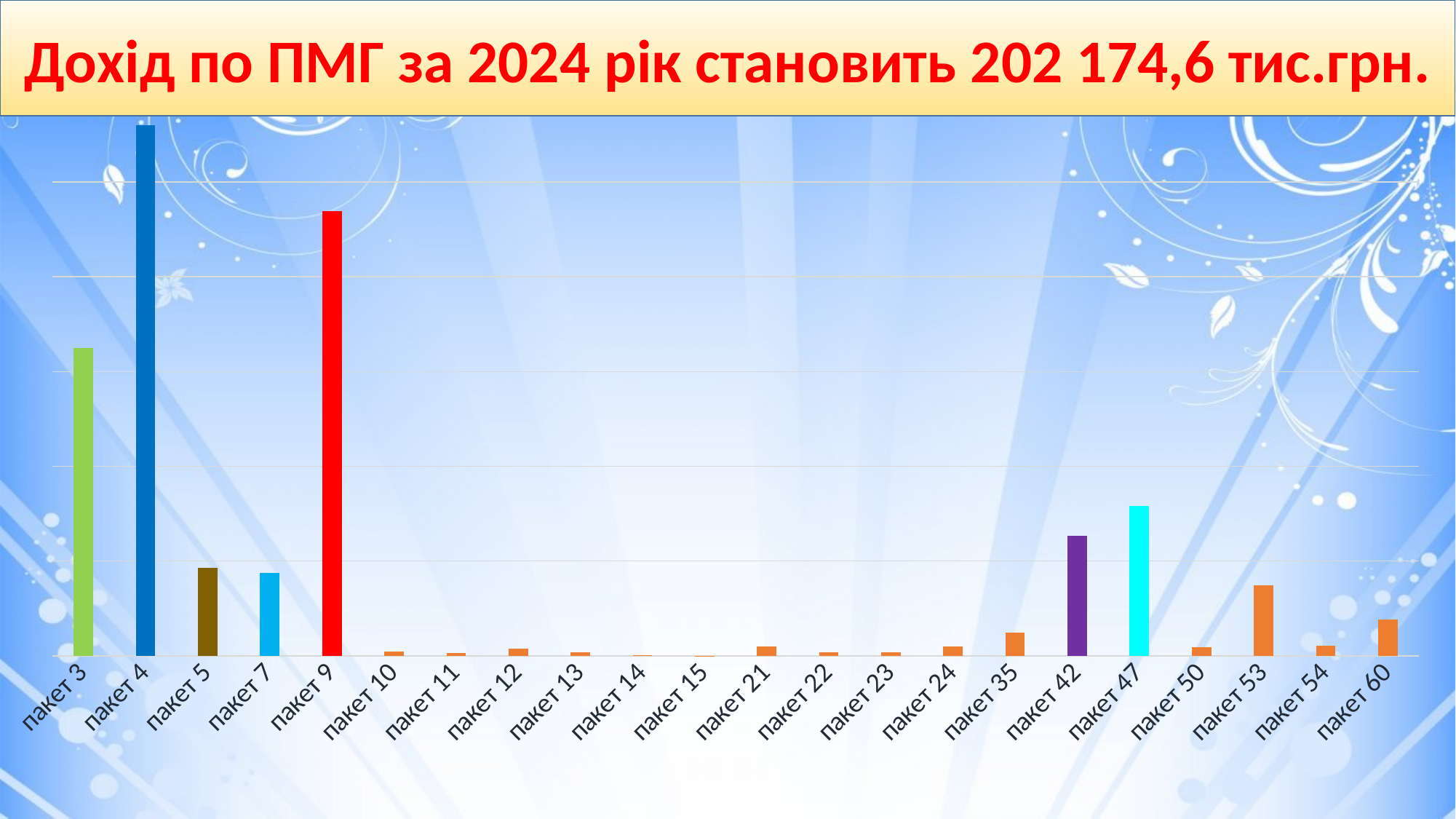
Which is larger, the value for пакет 42 or the value for пакет 47? пакет 47 How many categories (packages) are shown on the x axis of the chart? 22 Which is larger, the value for пакет 53 or the value for пакет 60? пакет 53 Which is larger, the value for пакет 4 or the value for пакет 9? пакет 4 According to the slide title, what is the total income from ПМГ for 2024? 202 174,6 тис.грн. Which package has the second highest bar in the chart? пакет 9 What kind of chart is shown on the slide? bar chart Which package has the highest bar in the chart? пакет 4 What colour is the bar for пакет 9? red